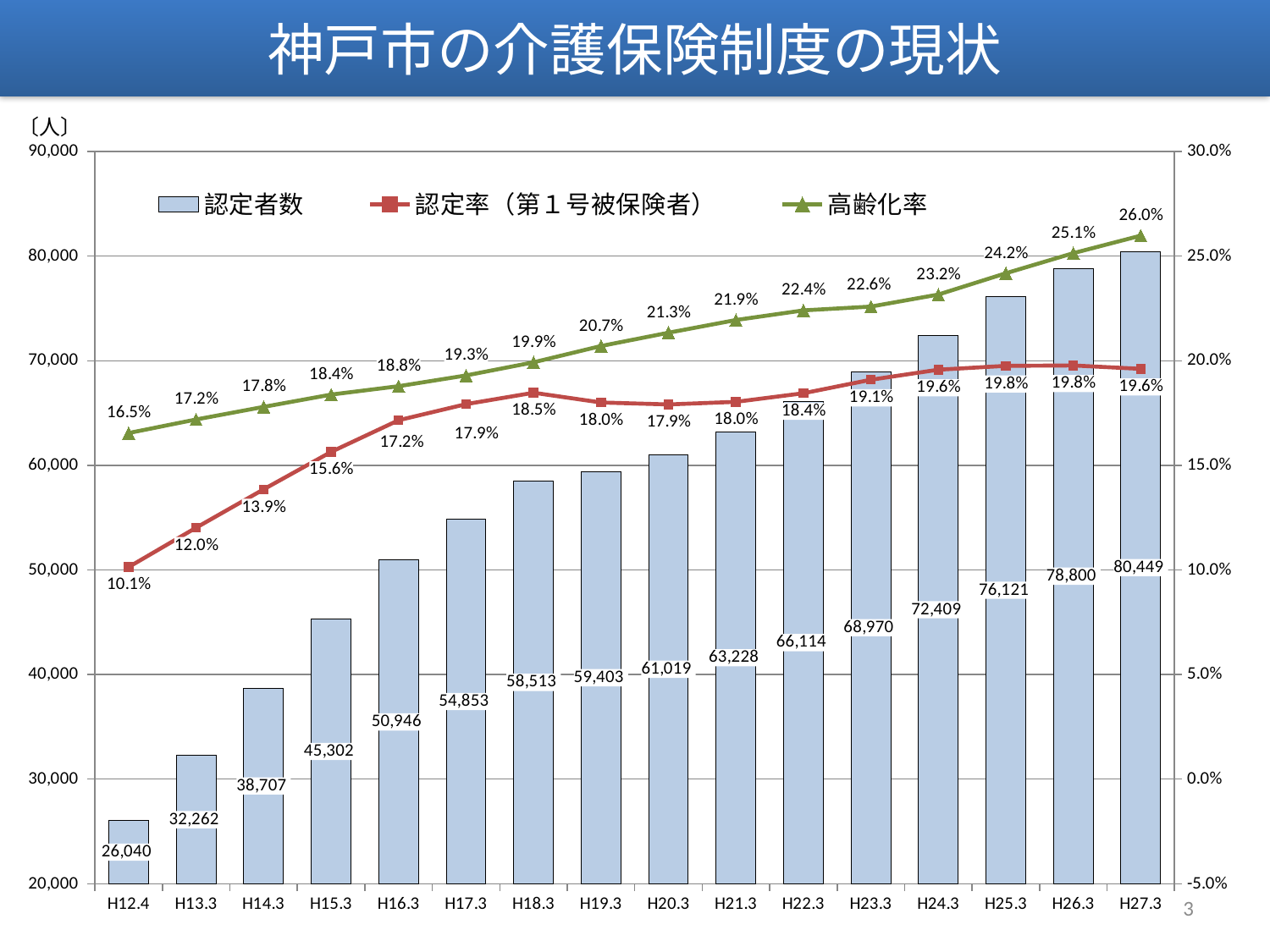
What is the difference in 認定者数 between H27.3 and H12.4? 54,409 What is the value of 認定者数 for H27.3? 80,449 Which category has the lowest 認定者数? H12.4 What is the 高齢化率 value for H20.3? 21.3% How many series does the legend list? 3 Which is larger, the 認定率 for H18.3 or the 認定率 for H19.3? H18.3 Does the 高齢化率 series rise or fall from H12.4 to H27.3? Rise What is the 認定率（第１号被保険者） value for H12.4? 10.1% Which category has the highest 高齢化率? H27.3 What kind of chart is this? Combination bar and line chart What is the title of the slide? 神戸市の介護保険制度の現状 How many categories are shown on the x axis? 16